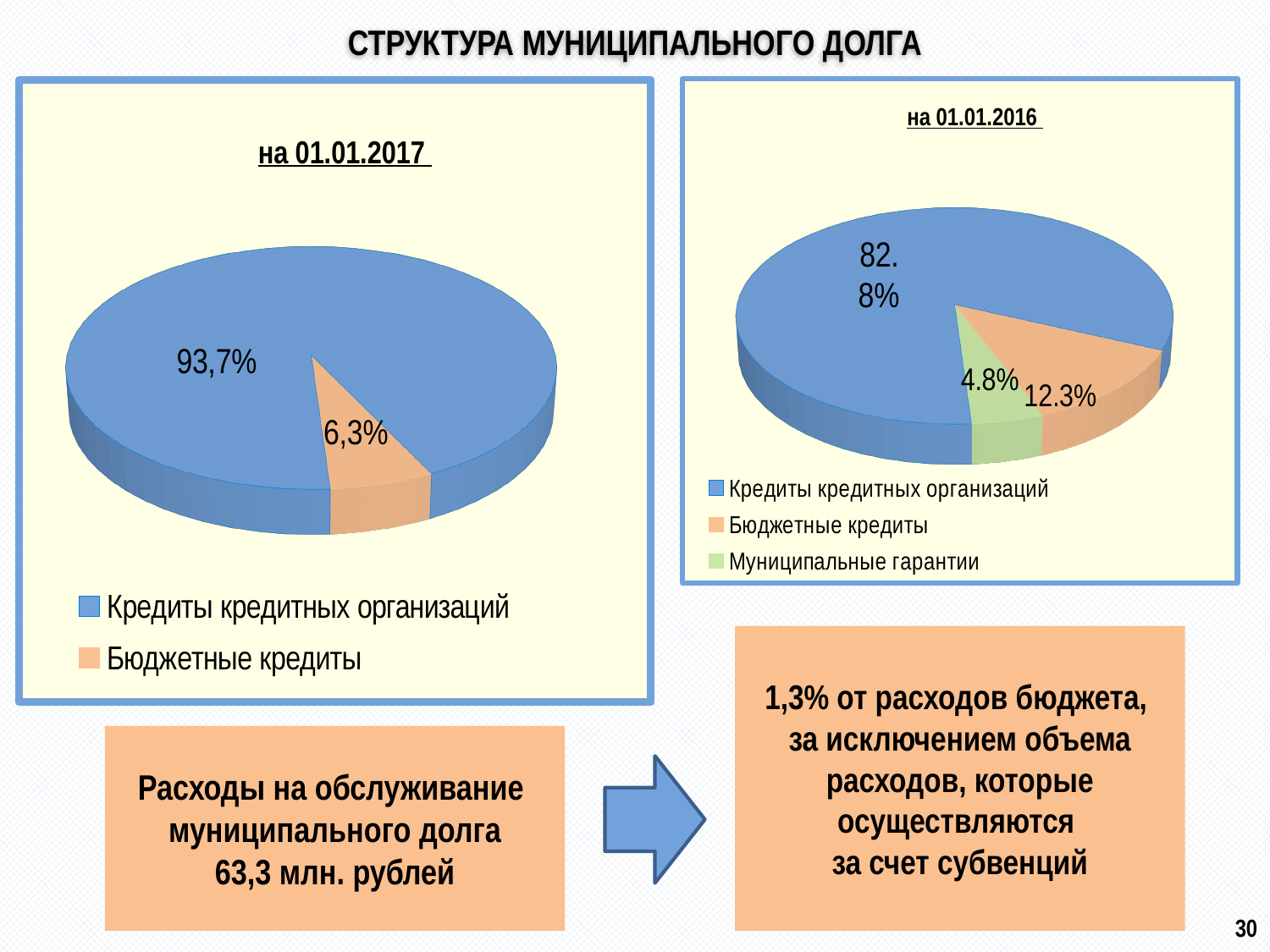
How many categories does the legend of the chart titled 'на 01.01.2017' list? 2 In the chart titled 'на 01.01.2016', which category has the smallest slice? Муниципальные гарантии In the chart titled 'на 01.01.2016', what share is shown for Муниципальные гарантии? 4.8% In the chart titled 'на 01.01.2017', which category has the largest slice? Кредиты кредитных организаций In the chart titled 'на 01.01.2016', what share is shown for Кредиты кредитных организаций? 82.8% In the chart titled 'на 01.01.2016', which is larger: Бюджетные кредиты or Муниципальные гарантии? Бюджетные кредиты In the chart titled 'на 01.01.2017', what share is shown for Бюджетные кредиты? 6,3% In the chart titled 'на 01.01.2016', what colour is the slice for Муниципальные гарантии? Green What type of chart is the chart titled 'на 01.01.2017'? Pie chart In the chart titled 'на 01.01.2016', what share is shown for Бюджетные кредиты? 12.3% In the chart titled 'на 01.01.2017', what share is shown for Кредиты кредитных организаций? 93,7% How many slices does the chart titled 'на 01.01.2016' have? 3